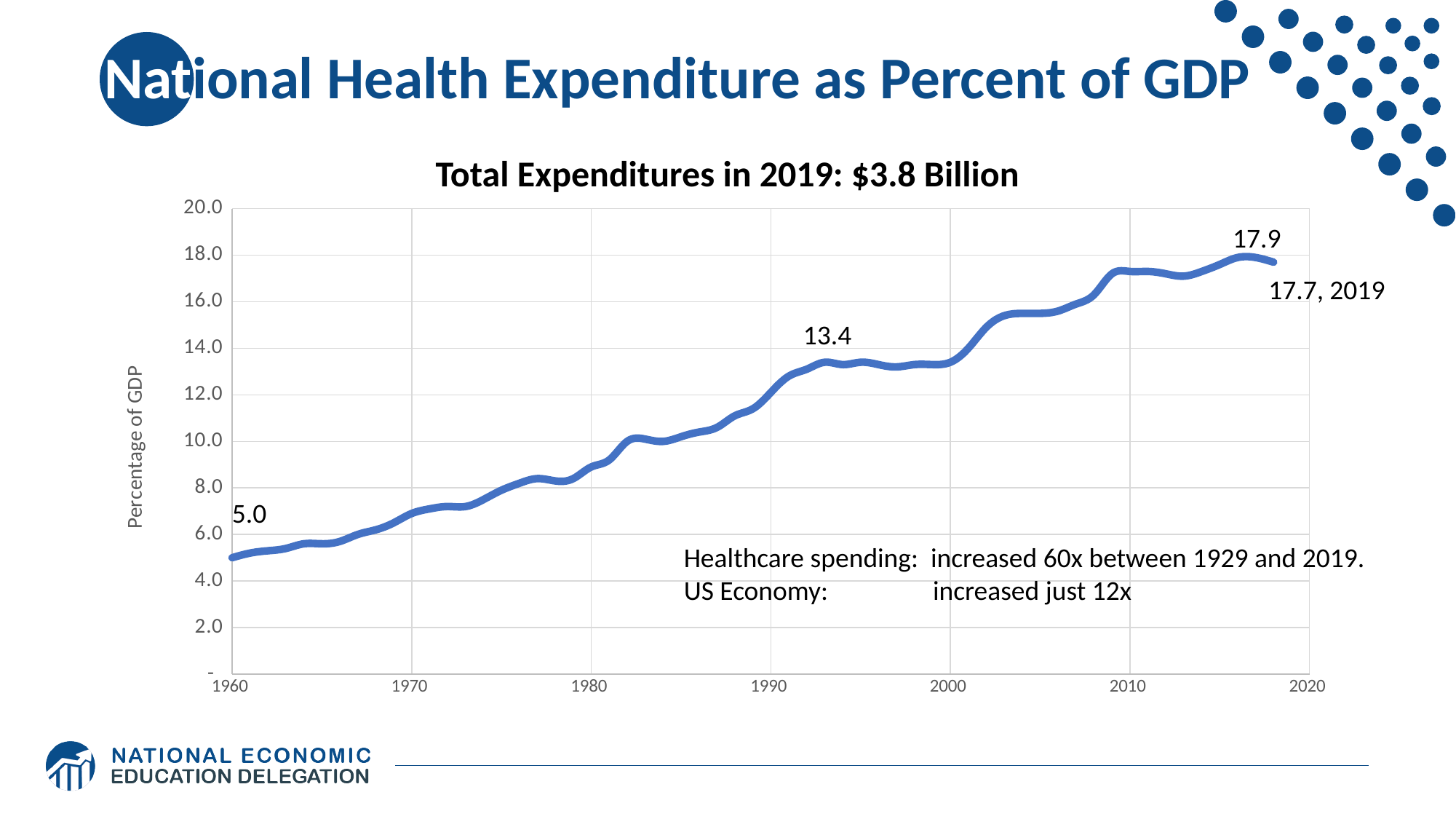
What was national health expenditure as a percent of GDP in 1960, according to the data label? 5.0 What is the difference between the peak labeled value of 17.9 and the 2019 value of 17.7? 0.2 Which year has the larger value, 1980 or 1990? 1990 What value is labeled for 2019 on the chart? 17.7 What kind of chart is shown on the slide? line chart Is the value for 1980 greater or less than 10.0? less Does the line generally rise or fall from 1960 to 2019? rise By how many percentage points did the labeled value rise from 1960 (5.0) to 2019 (17.7)? 12.7 What is the data label shown on the line between 1990 and 2000? 13.4 What is the lowest labeled value on the chart, and in which year does it occur? 5.0, in 1960 What is the highest value labeled on the line? 17.9 Is the value for 2010 greater or less than 16.0? greater